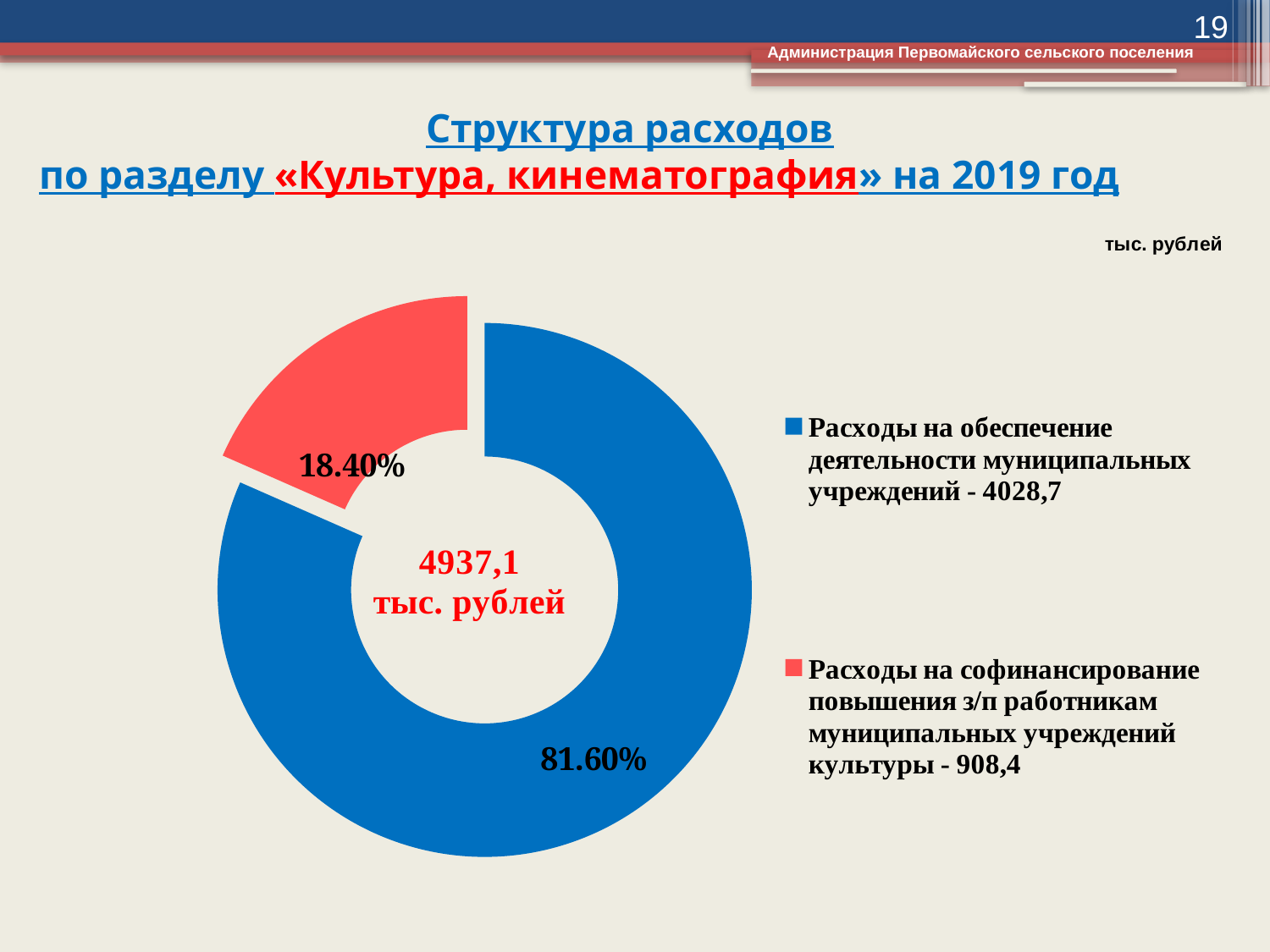
What value is given in the legend for 'Расходы на обеспечение деятельности муниципальных учреждений'? 4028,7 What value is given in the legend for 'Расходы на софинансирование повышения з/п работникам муниципальных учреждений культуры'? 908,4 What is the difference in percentage points between the two slices of the pie? 63.20% Which is larger: the share for 'Расходы на обеспечение деятельности муниципальных учреждений' or the share for 'Расходы на софинансирование повышения з/п работникам муниципальных учреждений культуры'? Расходы на обеспечение деятельности муниципальных учреждений What share of the pie does the slice for 'Расходы на софинансирование повышения з/п работникам муниципальных учреждений культуры' represent? 18.40% Which category has the smallest share of the pie? Расходы на софинансирование повышения з/п работникам муниципальных учреждений культуры What colour is the slice for 'Расходы на софинансирование повышения з/п работникам муниципальных учреждений культуры'? Red What kind of chart is shown on the slide? Pie chart (doughnut) What share of the pie does the slice for 'Расходы на обеспечение деятельности муниципальных учреждений' represent? 81.60% Which category has the largest share of the pie? Расходы на обеспечение деятельности муниципальных учреждений What total is shown in the centre of the doughnut chart? 4937,1 тыс. рублей How many categories does the legend list? 2